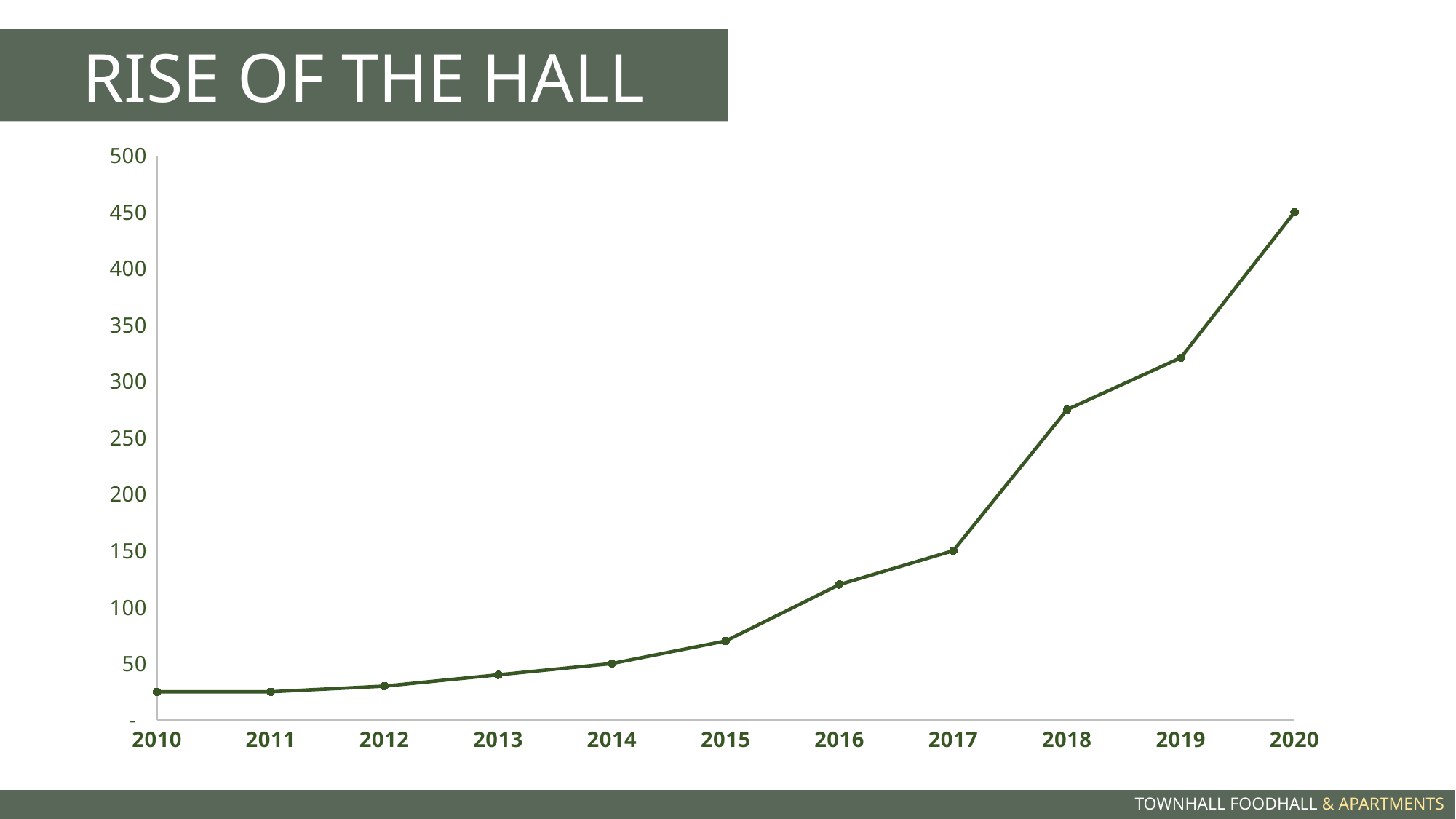
What is the value for 2014? 50 Is the value for 2015 greater or less than 100? less Which is larger, the value for 2016 or the value for 2018? 2018 What is the value for 2017? 150 How many years are plotted along the x axis? 11 Do the values generally rise or fall from 2010 to 2020? rise Which year has the highest value? 2020 What is the value for 2020? 450 What is the title of the chart on the slide? RISE OF THE HALL Is the value for 2018 greater or less than 250? greater Is the value for 2019 greater or less than 300? greater What kind of chart is shown on the slide? line chart